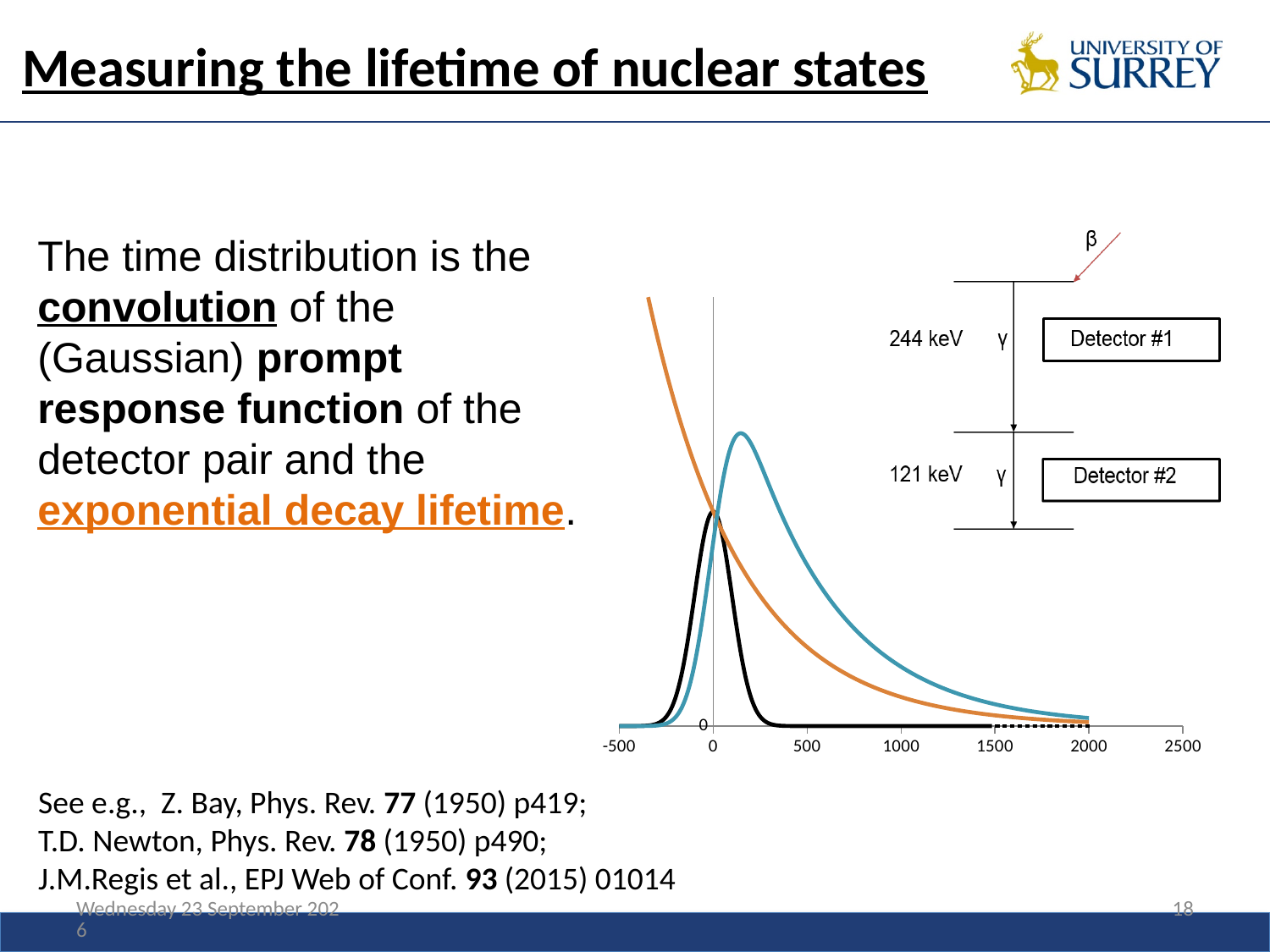
Which curve on the chart is highest at x = -500? the orange curve What value is labelled on the y axis of the chart? 0 How many tick labels are shown on the x axis of the chart? 7 Does the blue curve rise or fall as the x axis increases from 500 to 2000? fall Is the x position of the blue curve's peak greater or less than 0? greater What is the highest value labelled on the x axis of the chart? 2500 What kind of chart is shown on the slide? line chart How many curves are plotted on the chart? 3 Is the x position of the blue curve's peak greater or less than 500? less What is the lowest value labelled on the x axis of the chart? -500 Which curve peaks at x = 0 on the chart? the black curve Does the orange curve rise or fall as the x axis increases? fall